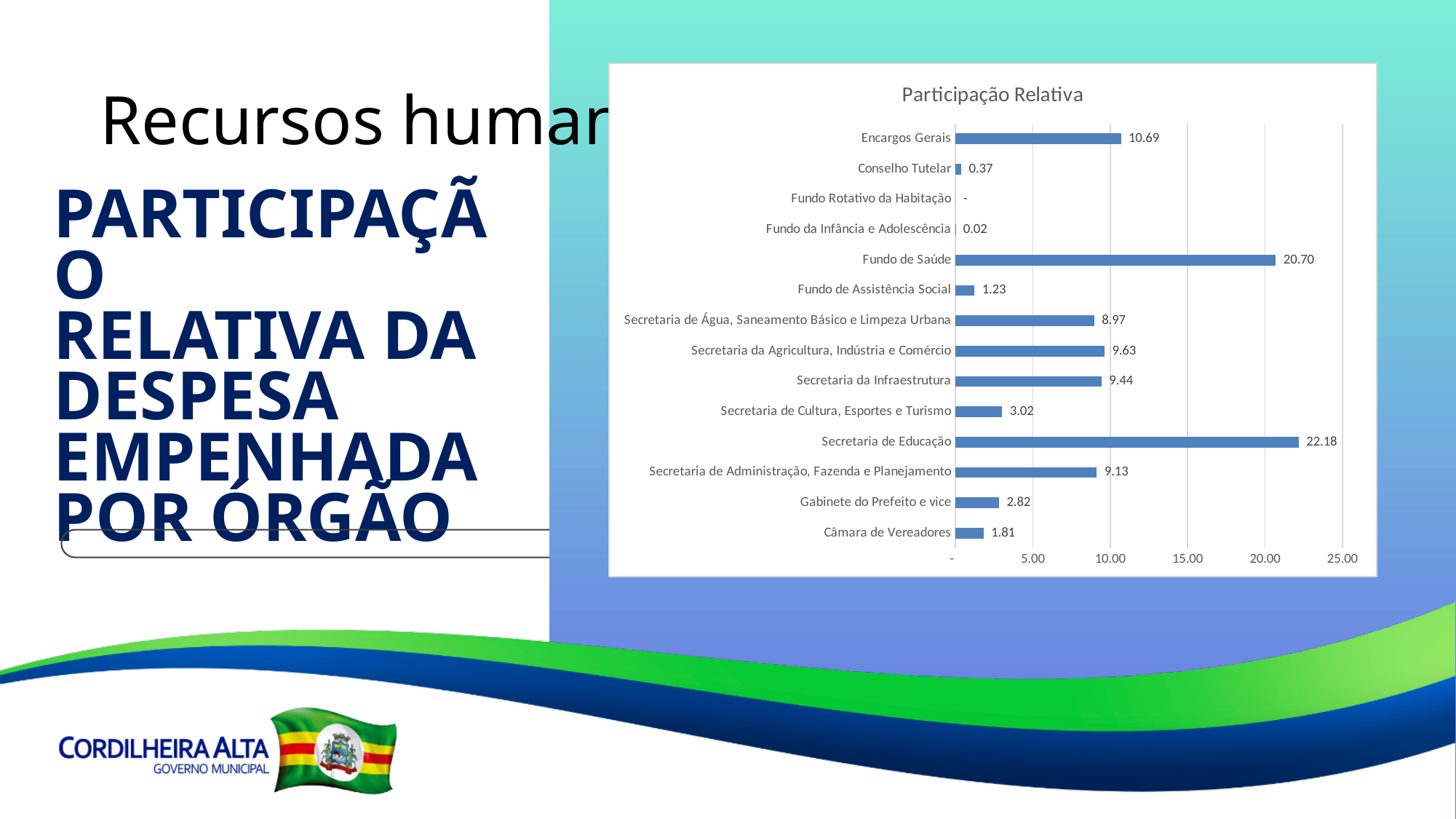
Is the value for Fundo de Saúde greater or less than 20.00? greater What kind of chart is shown on the slide? bar chart What is the difference between the values for Secretaria de Educação and Fundo de Saúde? 1.48 Which is larger, the value for Secretaria da Agricultura, Indústria e Comércio or the value for Secretaria da Infraestrutura? Secretaria da Agricultura, Indústria e Comércio What is the value for Fundo de Saúde? 20.70 What is the value for Encargos Gerais? 10.69 What is the value for Gabinete do Prefeito e vice? 2.82 What is the value for Secretaria de Educação? 22.18 How many categories are shown in the chart? 14 Which category has the highest value? Secretaria de Educação What is the value for Câmara de Vereadores? 1.81 What is the title of the chart? Participação Relativa